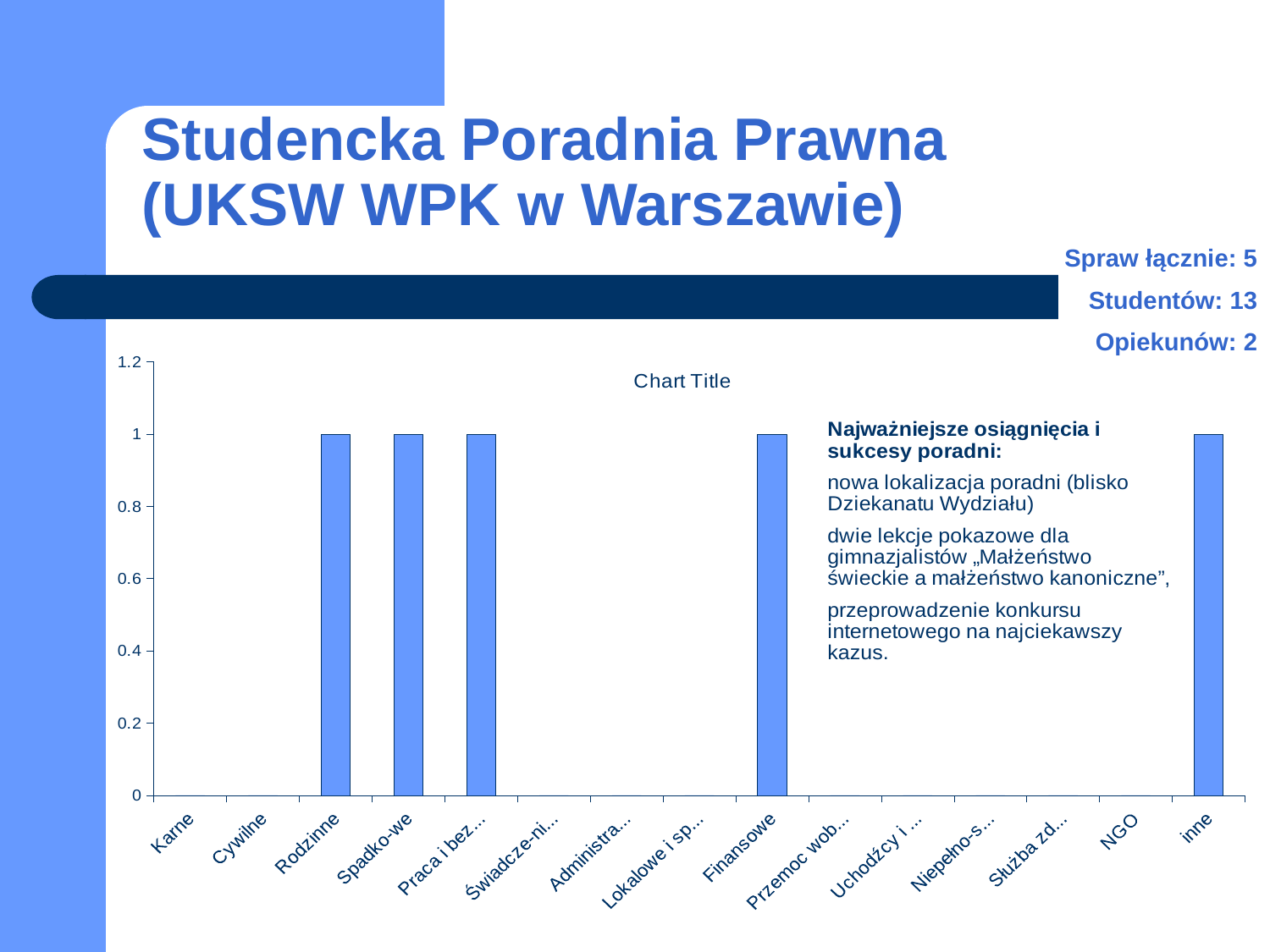
What kind of chart is shown on the slide? bar chart What is the value for NGO? 0 What is the value for Rodzinne? 1 What is the title of the chart? Chart Title What is the difference between the value for Finansowe and the value for Przemoc wob...? 1 What is the value for Karne? 0 What is the value for Finansowe? 1 What is the value for inne? 1 How many categories are shown on the x axis? 15 Is the value for Rodzinne greater or less than 0.8? greater How many categories have a value of 1? 5 Which is larger, the value for Spadko-we or the value for Cywilne? Spadko-we